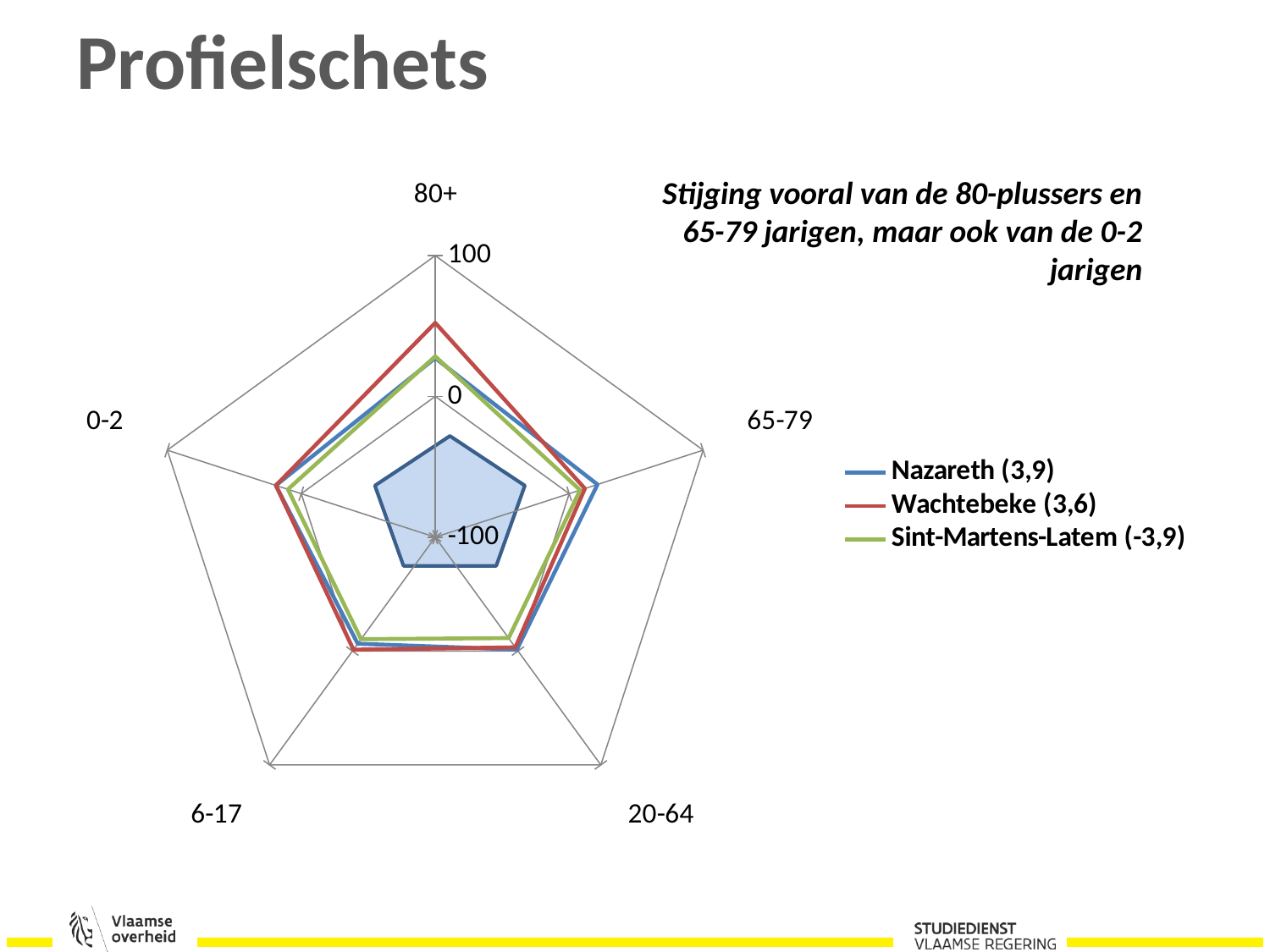
At 80+, which series has the larger value: Wachtebeke (3,6) or Sint-Martens-Latem (-3,9)? Wachtebeke (3,6) What kind of chart is shown on the slide? radar chart How many age categories are plotted on the radar chart? 5 Is the value for Sint-Martens-Latem (-3,9) at 0-2 greater or less than 0? greater Which series is drawn in red on the radar chart? Wachtebeke (3,6) At 65-79, which series has the larger value: Nazareth (3,9) or Sint-Martens-Latem (-3,9)? Nazareth (3,9) Is the value for Nazareth (3,9) at 65-79 greater or less than 100? less Is the value for Wachtebeke (3,6) at 80+ greater or less than 0? greater How many series does the legend of the radar chart list? 3 At 80+, which series has the larger value: Wachtebeke (3,6) or Nazareth (3,9)? Wachtebeke (3,6) What is the highest value shown on the radar chart's axis? 100